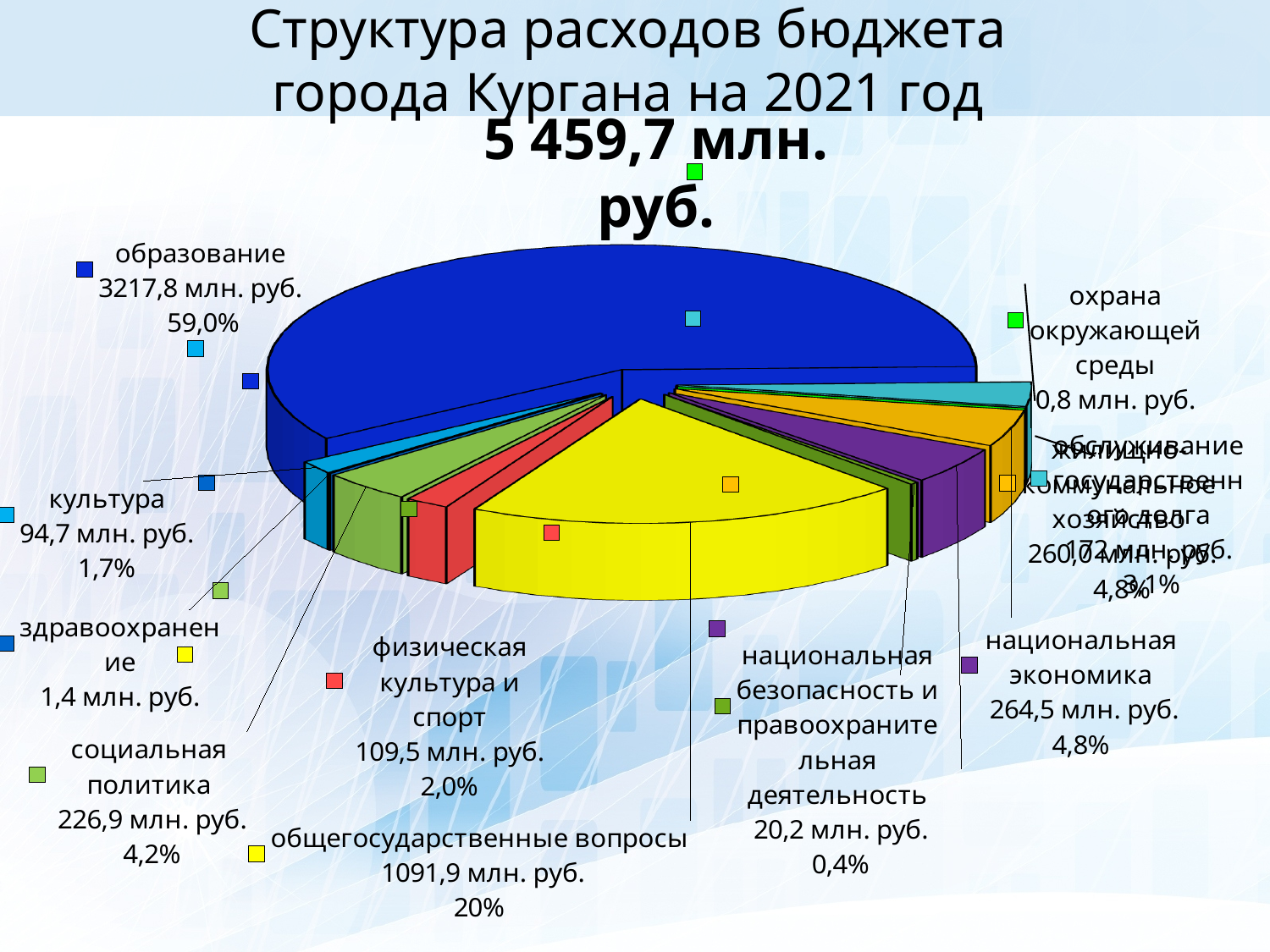
What is the value for национальная экономика? 264,5 млн. руб. What share of the pie does образование take? 59,0% What share of the pie does общегосударственные вопросы take? 20% What is the value for социальная политика? 226,9 млн. руб. Which is larger, the value for культура or the value for физическая культура и спорт? физическая культура и спорт What total amount is shown above the pie chart? 5 459,7 млн. руб. What is the value for образование? 3217,8 млн. руб. What is the difference between the values for образование and общегосударственные вопросы? 2125,9 млн. руб. What kind of chart is shown on the slide? pie chart Which category has the largest slice of the pie? образование What is the value for общегосударственные вопросы? 1091,9 млн. руб. Which category has the smallest value? охрана окружающей среды